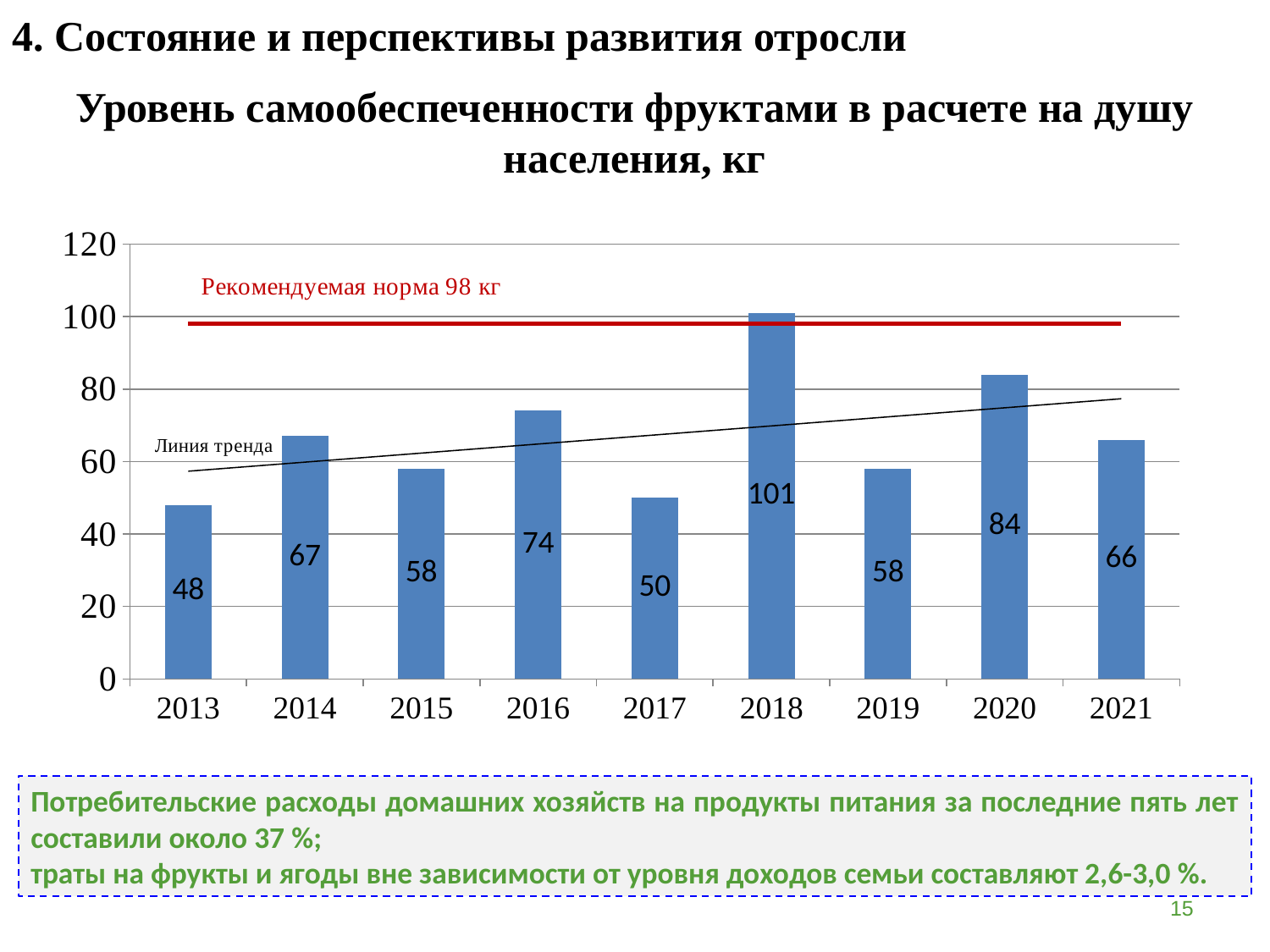
What recommended norm is marked by the red line on the chart? 98 кг Which year has the lowest value? 2013 Is the value for 2020 greater or less than 80? greater What is the difference between the values for 2018 and 2020? 17 Which is larger, the value for 2014 or the value for 2021? 2014 Which year has the highest value? 2018 What is the value for 2021? 66 How many years are shown on the x axis? 9 What kind of chart is this? bar chart What is the value for 2013? 48 What is the value for 2018? 101 What is the difference between the values for 2016 and 2017? 24